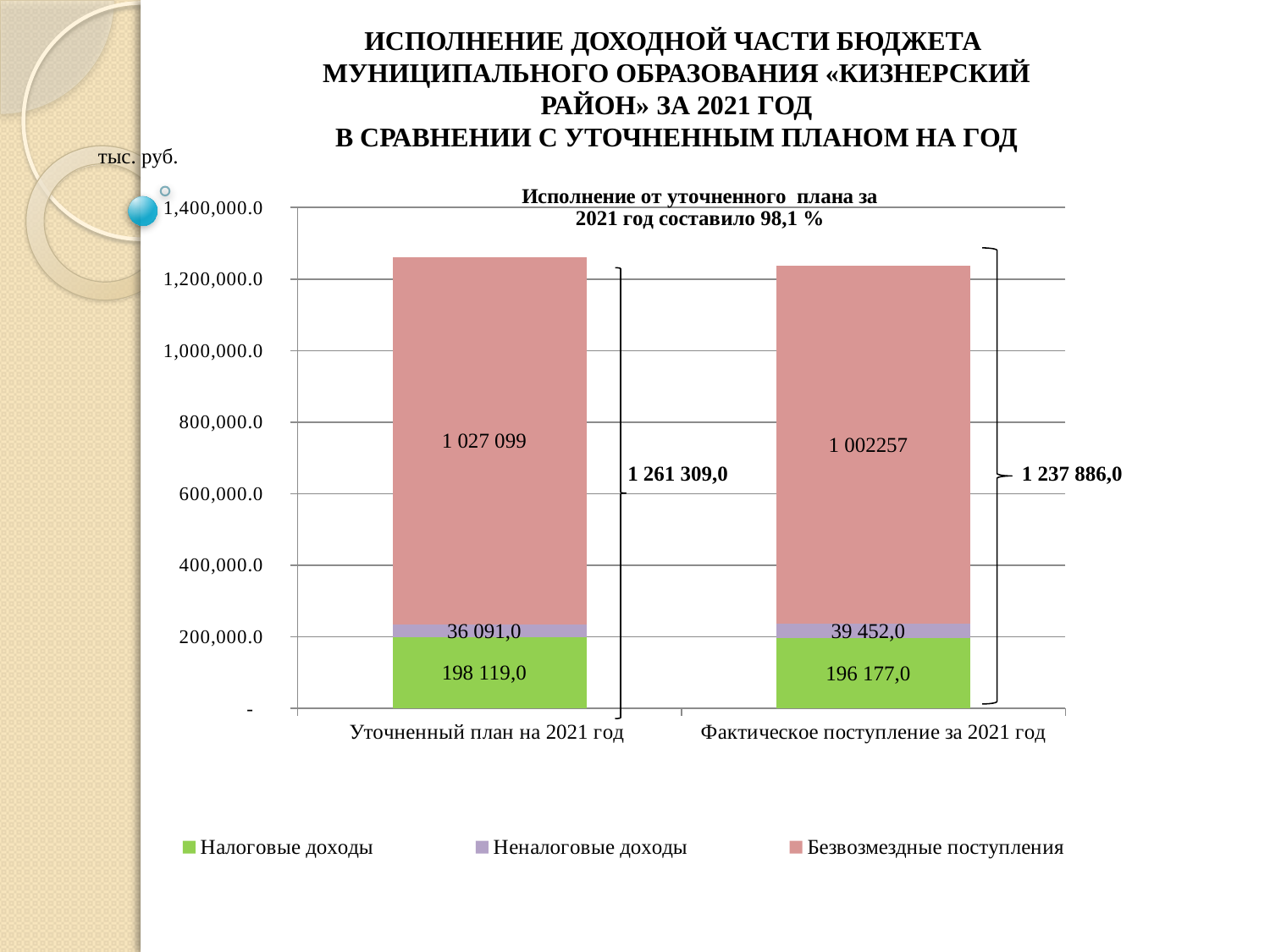
What kind of chart is shown on the slide? Stacked bar chart How many series does the legend list? 3 How many categories are shown on the x axis? 2 What is the value of Налоговые доходы for Фактическое поступление за 2021 год? 196 177,0 Which is larger: Неналоговые доходы for Уточненный план на 2021 год or for Фактическое поступление за 2021 год? Фактическое поступление за 2021 год What is the total of the stacked bar for Фактическое поступление за 2021 год? 1 237 886,0 What is the difference between Налоговые доходы for Уточненный план на 2021 год and for Фактическое поступление за 2021 год? 1 942,0 What percentage of the refined plan was executed in 2021, according to the chart title? 98,1 % What is the value of Налоговые доходы for Уточненный план на 2021 год? 198 119,0 What is the value of Неналоговые доходы for Фактическое поступление за 2021 год? 39 452,0 What is the value of Безвозмездные поступления for Уточненный план на 2021 год? 1 027 099 What is the total of the stacked bar for Уточненный план на 2021 год? 1 261 309,0